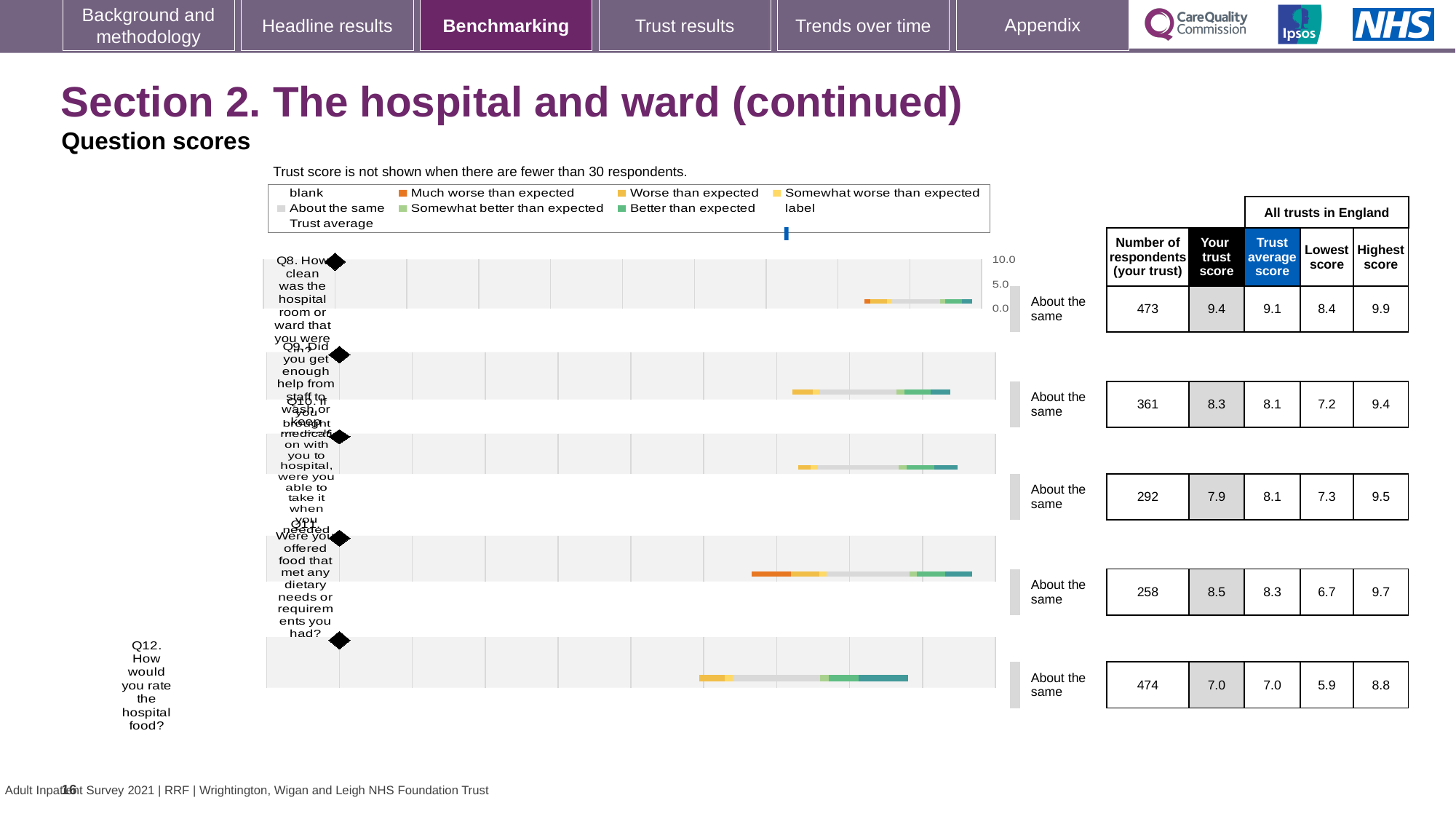
How many respondents from your trust answered Q8 (how clean was the hospital room or ward)? 473 What kind of chart is used to show the question scores? Bar chart What is the trust average score for Q9 (did you get enough help from staff to wash or keep yourself clean)? 8.1 For Q8, how much higher is your trust score than the trust average score? 0.3 What is your trust score for Q12 (how would you rate the hospital food)? 7.0 Which question has the highest 'Your trust score'? Q8 Which question has the lowest 'Your trust score'? Q12 What is the highest score across all trusts in England for Q11 (were you offered food that met any dietary needs or requirements you had)? 9.7 Which has the larger 'Your trust score': Q9 or Q11? Q11 How many questions are plotted on the chart? 5 What is the lowest score across all trusts in England for Q10 (if you brought medication with you to hospital, were you able to take it when you needed to)? 7.3 What benchmark category is shown for Q10? About the same